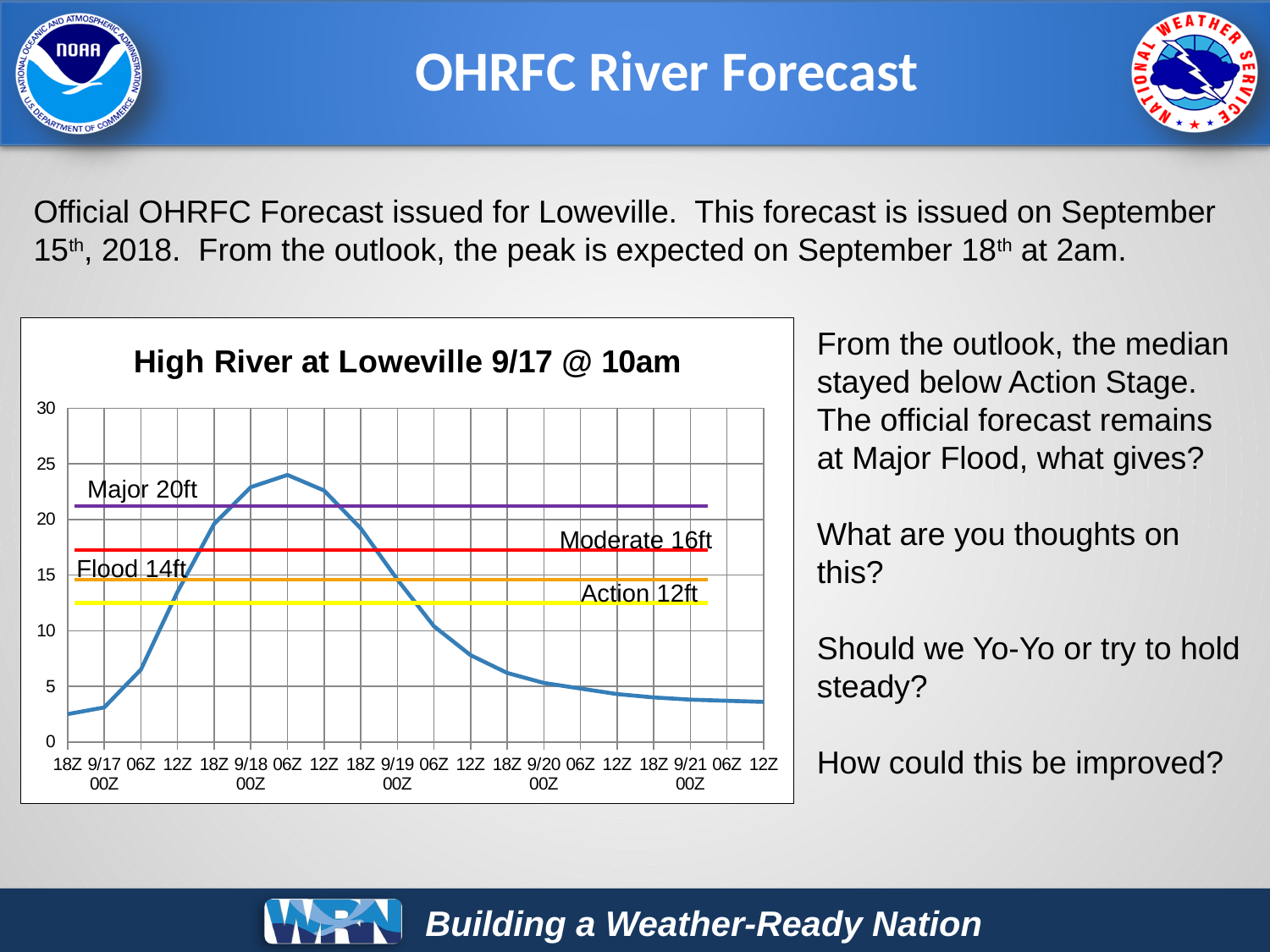
Is the peak value of the forecast river line greater or less than 20? greater What kind of chart is shown on the slide? line chart Is the value of the forecast river line at 9/19 00Z greater or less than 10? greater Is the value of the forecast river line at 9/17 00Z greater or less than 5? less What stage value is labeled for the Action category on the chart? 12ft What stage value is labeled for the Moderate category on the chart? 16ft Does the forecast river line rise or fall from 9/18 06Z to 9/21 12Z? fall What is the title of the chart? High River at Loweville 9/17 @ 10am How many horizontal flood-category reference lines are drawn on the chart? 4 What stage value is labeled for the Major category on the chart? 20ft At which x-axis time does the forecast river line reach its highest value? 9/18 06Z What stage value is labeled for the Flood category on the chart? 14ft